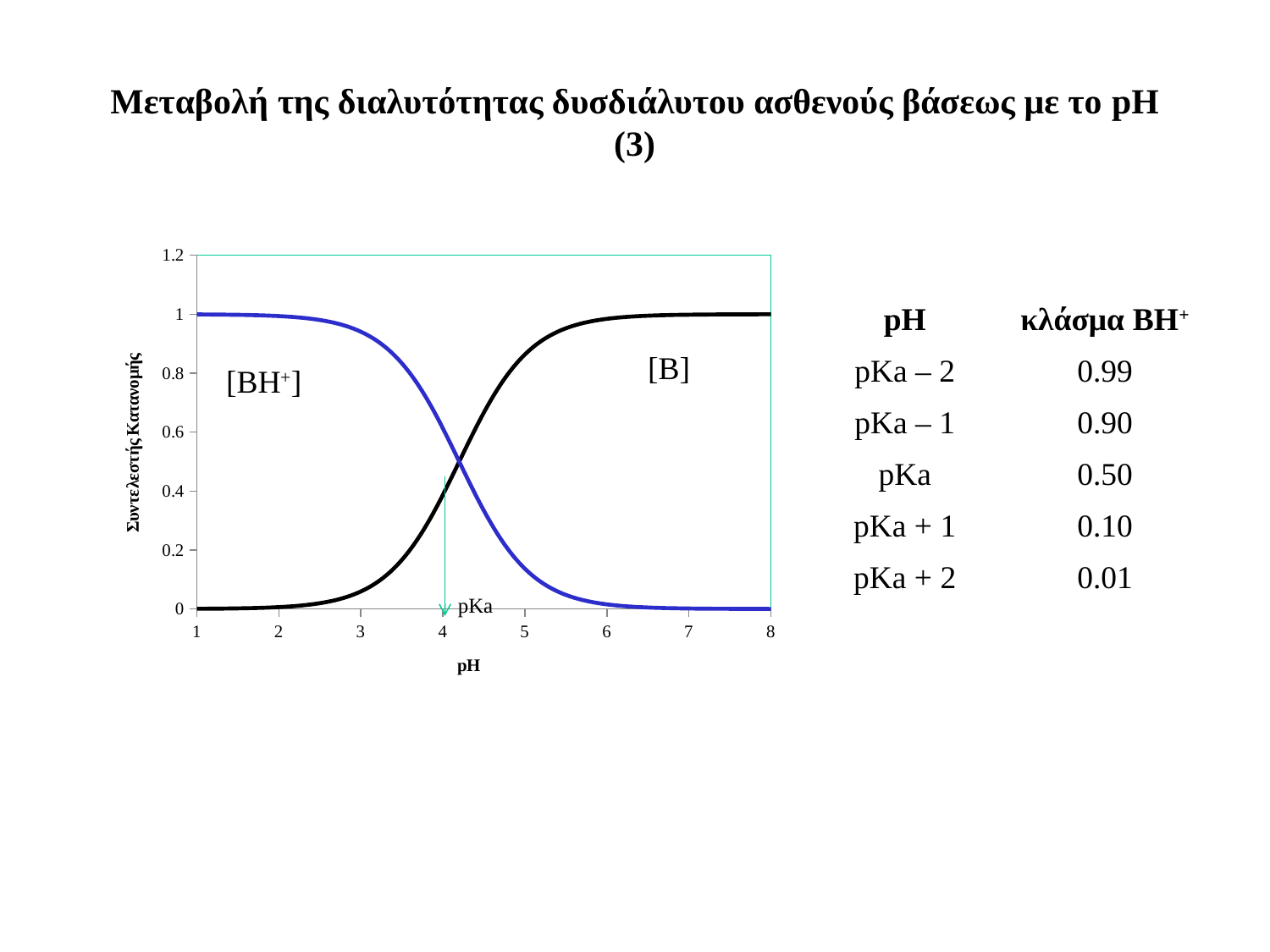
At pH 2, is the value of the [BH+] curve greater or less than 0.8? greater At pH 7, which curve has the larger value, [BH+] or [B]? [B] At pH 3, is the value of the [B] curve greater or less than 0.2? less At pH 6, is the value of the [BH+] curve greater or less than 0.2? less How many curves are plotted on the chart? 2 At pH 2, which curve has the larger value, [BH+] or [B]? [BH+] What is the label of the x axis of the chart? pH At which pH value on the x axis is the pKa marker placed? 4 What kind of chart is shown on the slide? line chart Does the [B] curve rise or fall as pH increases along the x axis? rise Does the [BH+] curve rise or fall as pH increases along the x axis? fall